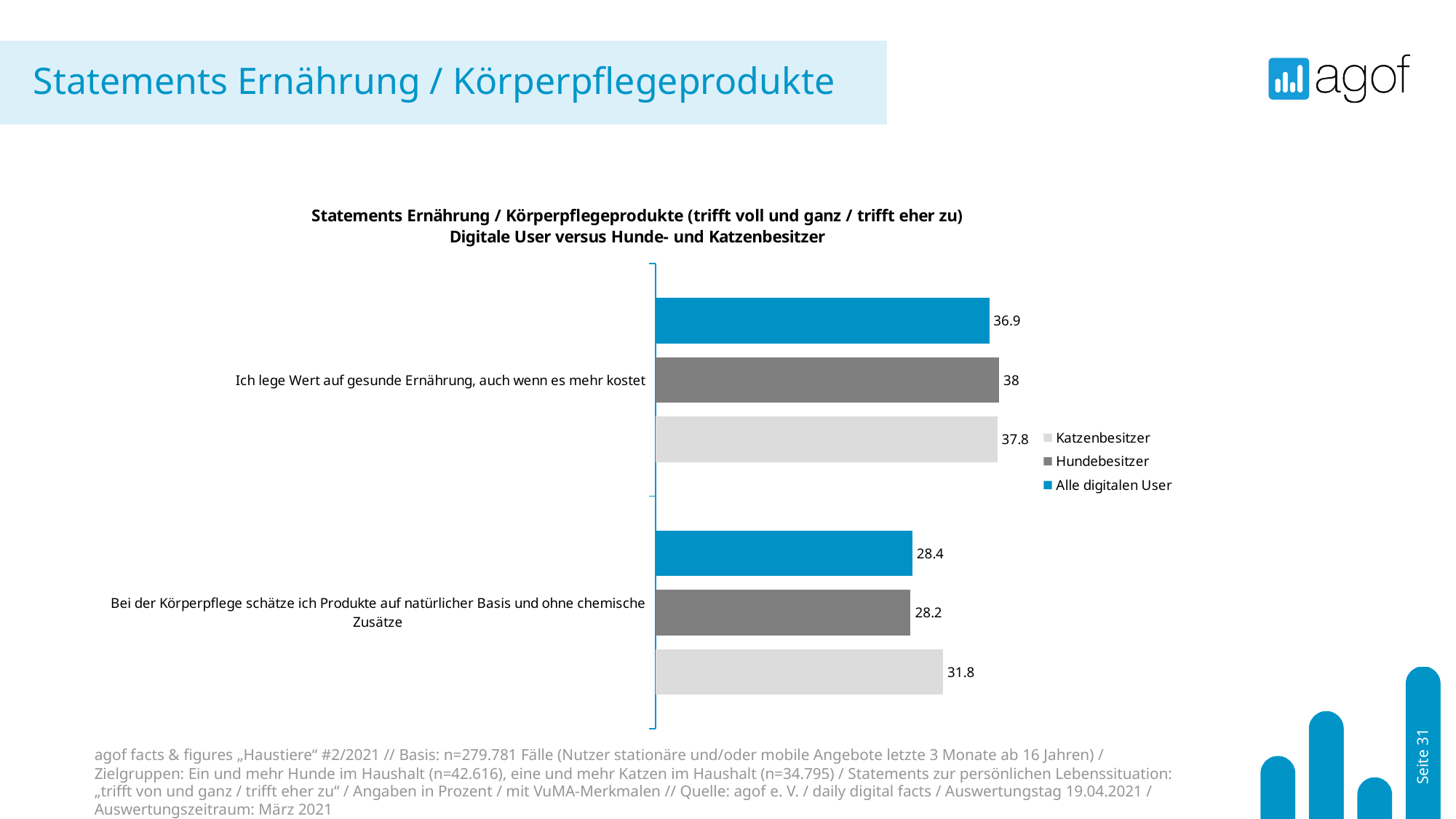
What is the value for Hundebesitzer for the statement "Ich lege Wert auf gesunde Ernährung, auch wenn es mehr kostet"? 38 Which group has the lowest value for the statement "Bei der Körperpflege schätze ich Produkte auf natürlicher Basis und ohne chemische Zusätze"? Hundebesitzer How many statements (categories) are shown in the chart? 2 For Katzenbesitzer, which statement has the larger value: "Ich lege Wert auf gesunde Ernährung, auch wenn es mehr kostet" or "Bei der Körperpflege schätze ich Produkte auf natürlicher Basis und ohne chemische Zusätze"? Ich lege Wert auf gesunde Ernährung, auch wenn es mehr kostet Which group has the highest value for the statement "Ich lege Wert auf gesunde Ernährung, auch wenn es mehr kostet"? Hundebesitzer What is the value for Hundebesitzer for the statement "Bei der Körperpflege schätze ich Produkte auf natürlicher Basis und ohne chemische Zusätze"? 28.2 What kind of chart is shown on the slide? Bar chart What is the value for Katzenbesitzer for the statement "Bei der Körperpflege schätze ich Produkte auf natürlicher Basis und ohne chemische Zusätze"? 31.8 How many series does the legend list? 3 What is the value for Alle digitalen User for the statement "Ich lege Wert auf gesunde Ernährung, auch wenn es mehr kostet"? 36.9 What is the difference between the Hundebesitzer and Alle digitalen User values for the statement "Ich lege Wert auf gesunde Ernährung, auch wenn es mehr kostet"? 1.1 What is the difference between the Katzenbesitzer and Alle digitalen User values for the statement "Bei der Körperpflege schätze ich Produkte auf natürlicher Basis und ohne chemische Zusätze"? 3.4